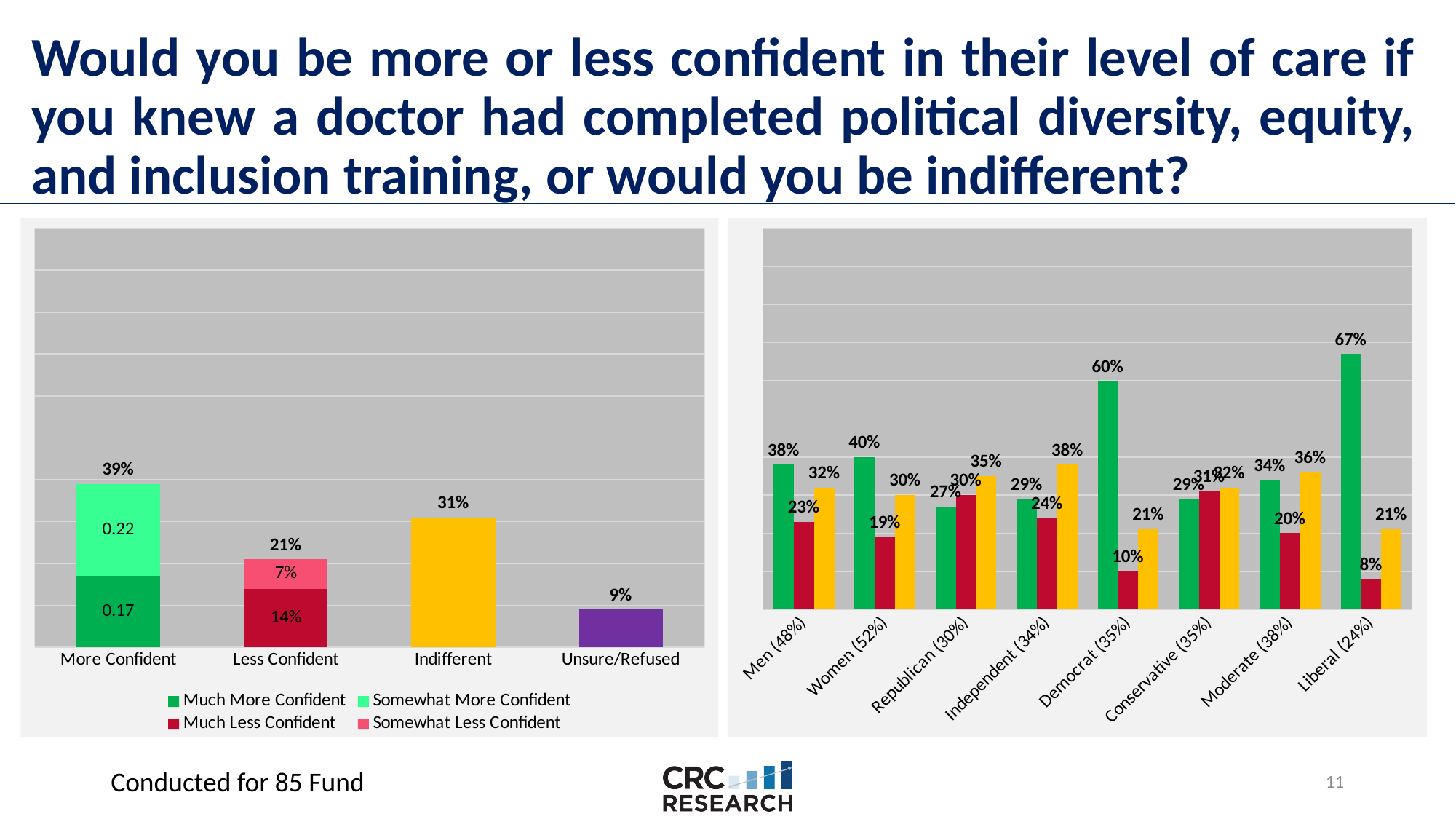
In the right chart, what is the value of the red bar for Liberal (24%)? 8% In the left chart, what is the value of the Much Less Confident segment of the Less Confident bar? 14% In the right chart, which is larger for Women (52%): the green bar or the yellow bar? the green bar In the left chart, what is the difference between the Indifferent value and the Unsure/Refused value? 22% In the right chart, how many groups are shown on the x axis? 8 In the left chart, which category has the lowest value? Unsure/Refused In the left chart, what is the total value shown for the Less Confident bar? 21% In the right chart, what is the value of the green bar for Democrat (35%)? 60% In the left chart, what is the value for Indifferent? 31% In the left chart, how many series does the legend list? 4 What kind of chart is the right chart? bar chart In the right chart, which group has the highest green bar? Liberal (24%)